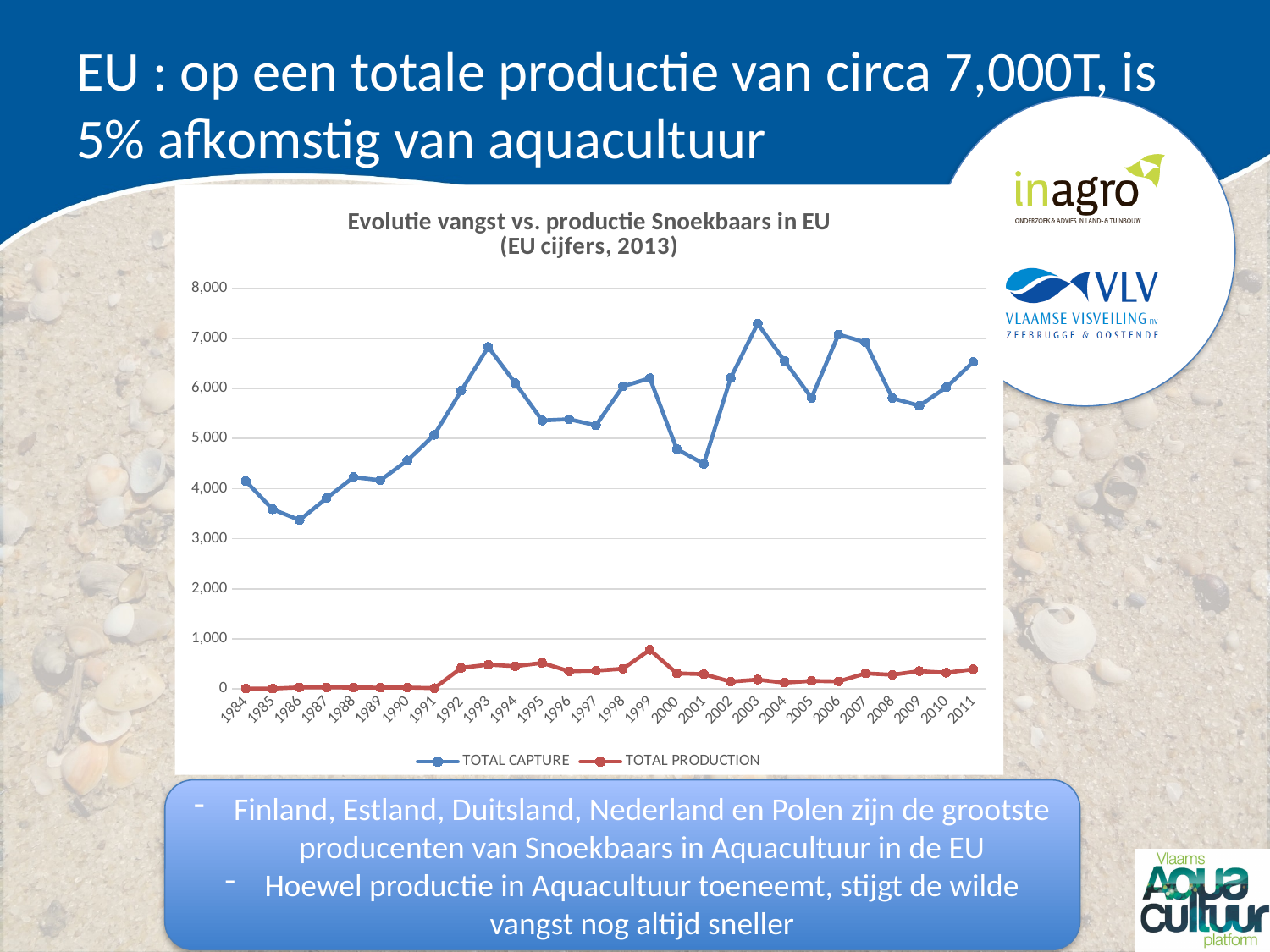
In which year is TOTAL PRODUCTION at its highest? 1999 Is the TOTAL CAPTURE value for 2001 greater or less than 5,000? less In 2011, which series has the larger value, TOTAL CAPTURE or TOTAL PRODUCTION? TOTAL CAPTURE Is the TOTAL CAPTURE value for 1993 greater or less than 6,000? greater What kind of chart is shown on the slide? line chart Does TOTAL CAPTURE rise or fall between 1986 and 1993? rise What are the two series named in the legend? TOTAL CAPTURE and TOTAL PRODUCTION How many series does the legend list? 2 How many years are plotted along the x axis? 28 What is the first year shown on the x axis? 1984 Is the TOTAL PRODUCTION value for 1999 greater or less than 1,000? less In which year is TOTAL CAPTURE at its lowest? 1986